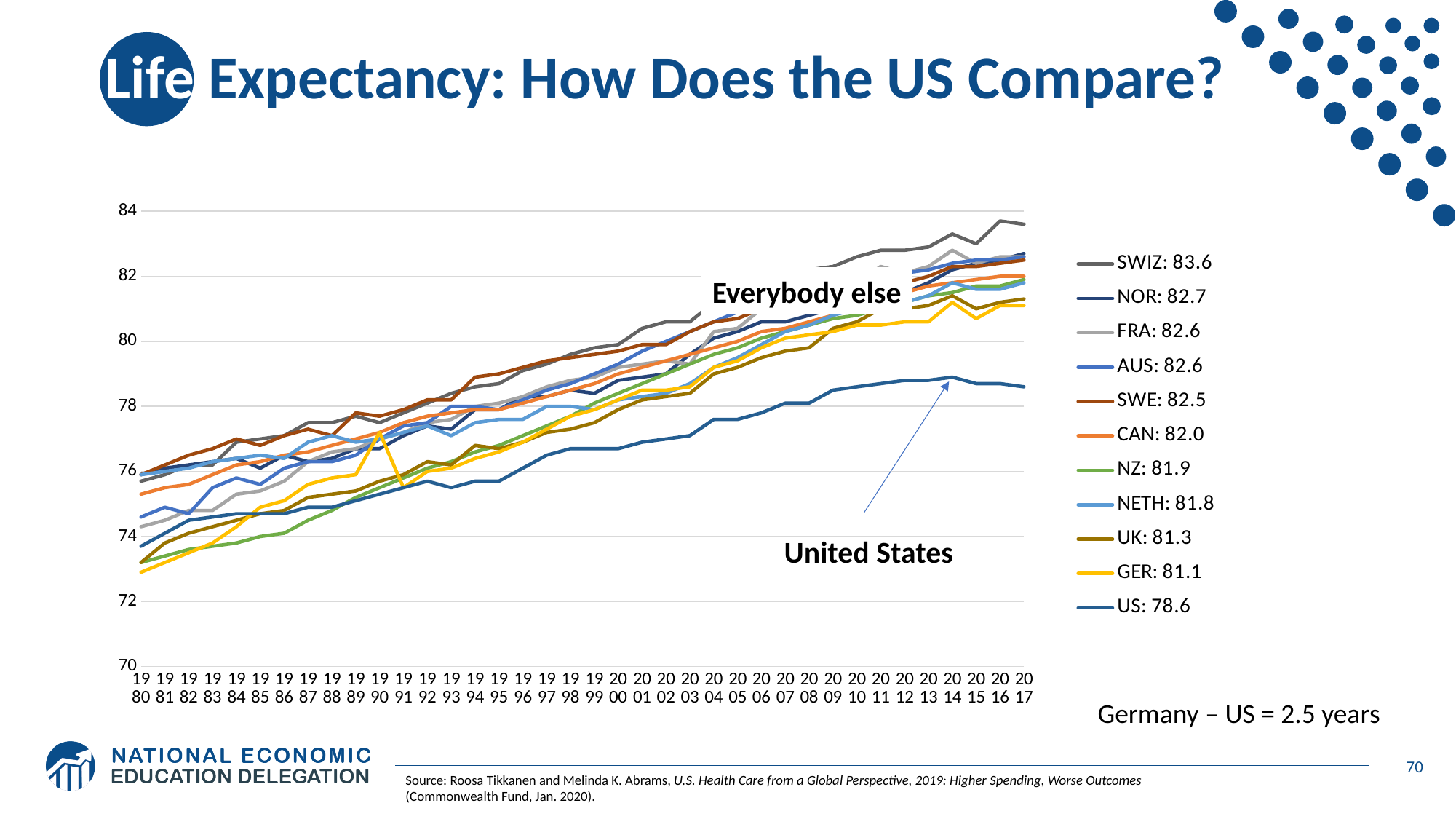
How many years are shown along the x axis? 38 Which has the larger legend value, CAN or NZ? CAN What kind of chart is shown on the slide? line chart What life expectancy value is shown for the US in the legend? 78.6 Does the US line rise or fall from 1980 to 2017? rise Which country has the lowest life expectancy value in the legend? US What life expectancy value is shown for SWIZ in the legend? 83.6 What is the difference between the SWIZ and NOR values shown in the legend? 0.9 Is the value for the US in 1980 greater or less than 74? less What is the difference between the GER and US values shown in the legend? 2.5 How many series does the legend list? 11 Which country has the highest life expectancy value in the legend? SWIZ